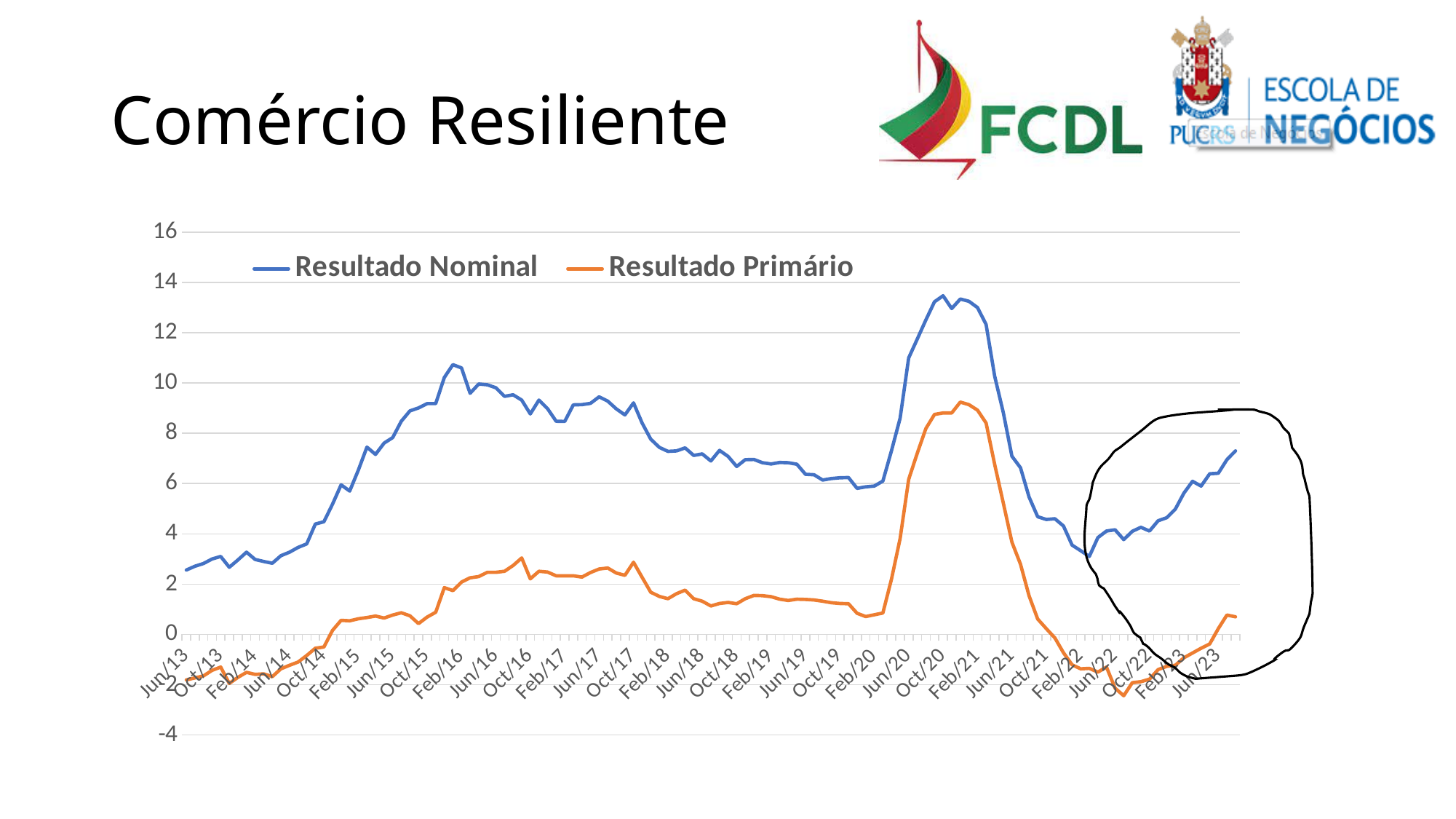
Is the value of Resultado Nominal at Feb/21 greater or less than 12? greater What colour is the Resultado Primário line? orange Is the value of Resultado Nominal at Feb/16 greater or less than 10? greater Which series reaches the higher peak, Resultado Nominal or Resultado Primário? Resultado Nominal How many series does the legend list? 2 Is the value of Resultado Primário at Jun/13 greater or less than 0? less What kind of chart is shown on the slide? line chart What are the two series named in the legend? Resultado Nominal and Resultado Primário At Feb/21, which series has the larger value, Resultado Nominal or Resultado Primário? Resultado Nominal Does the Resultado Nominal line rise or fall between Jun/22 and Jun/23? rise